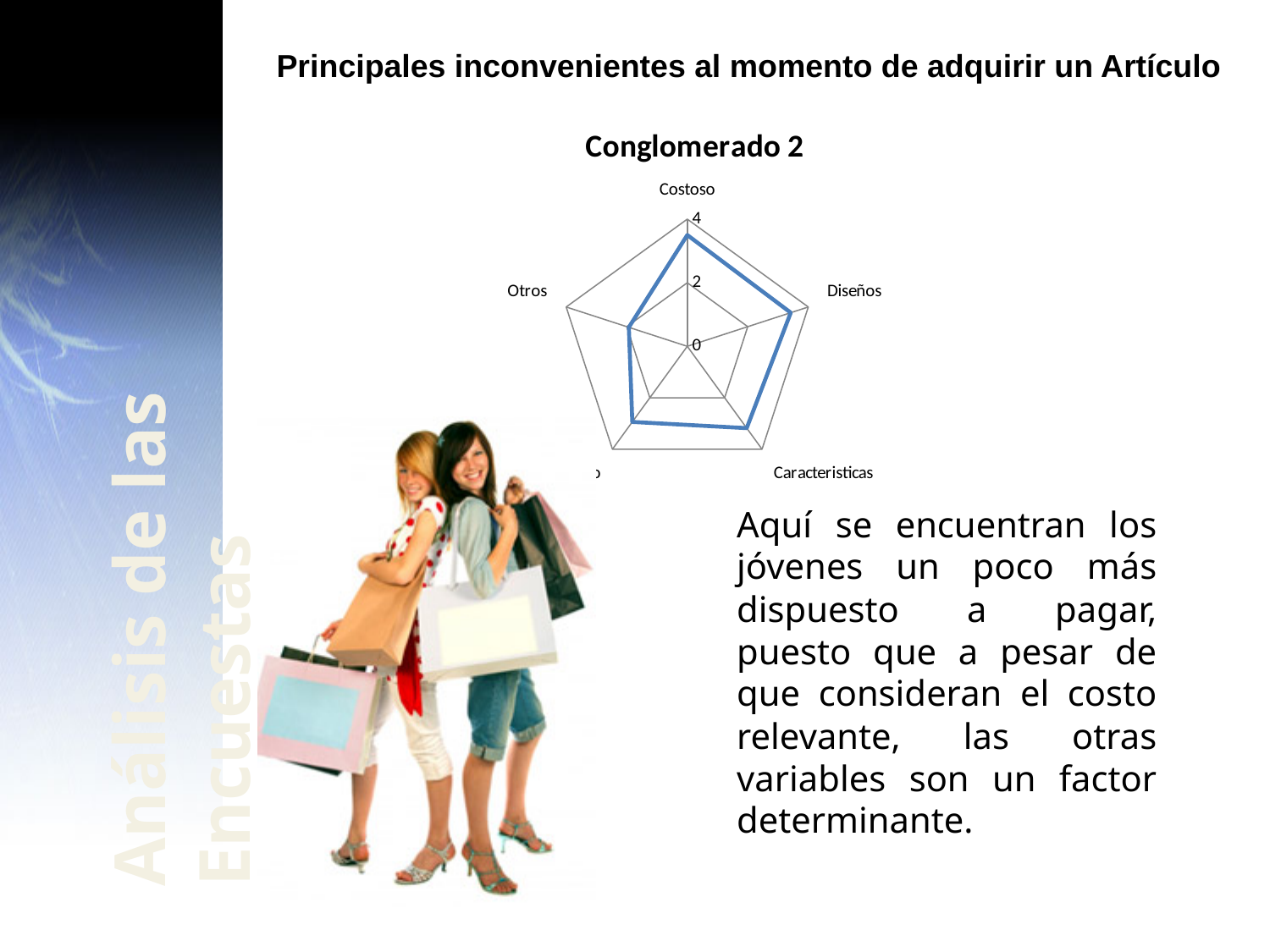
What kind of chart is shown on the slide? Radar chart Which is larger, the value for Costoso or the value for Otros? Costoso Is the value for Diseños greater or less than 2? greater How many categories (axes) does the radar chart have? 5 Which is larger, the value for Diseños or the value for Otros? Diseños What is the highest tick value shown on the chart's axis? 4 Which category has the lowest value in the chart? Otros Is the value for Otros greater or less than 4? less Is the value for Caracteristicas greater or less than 2? greater What is the title of the chart? Conglomerado 2